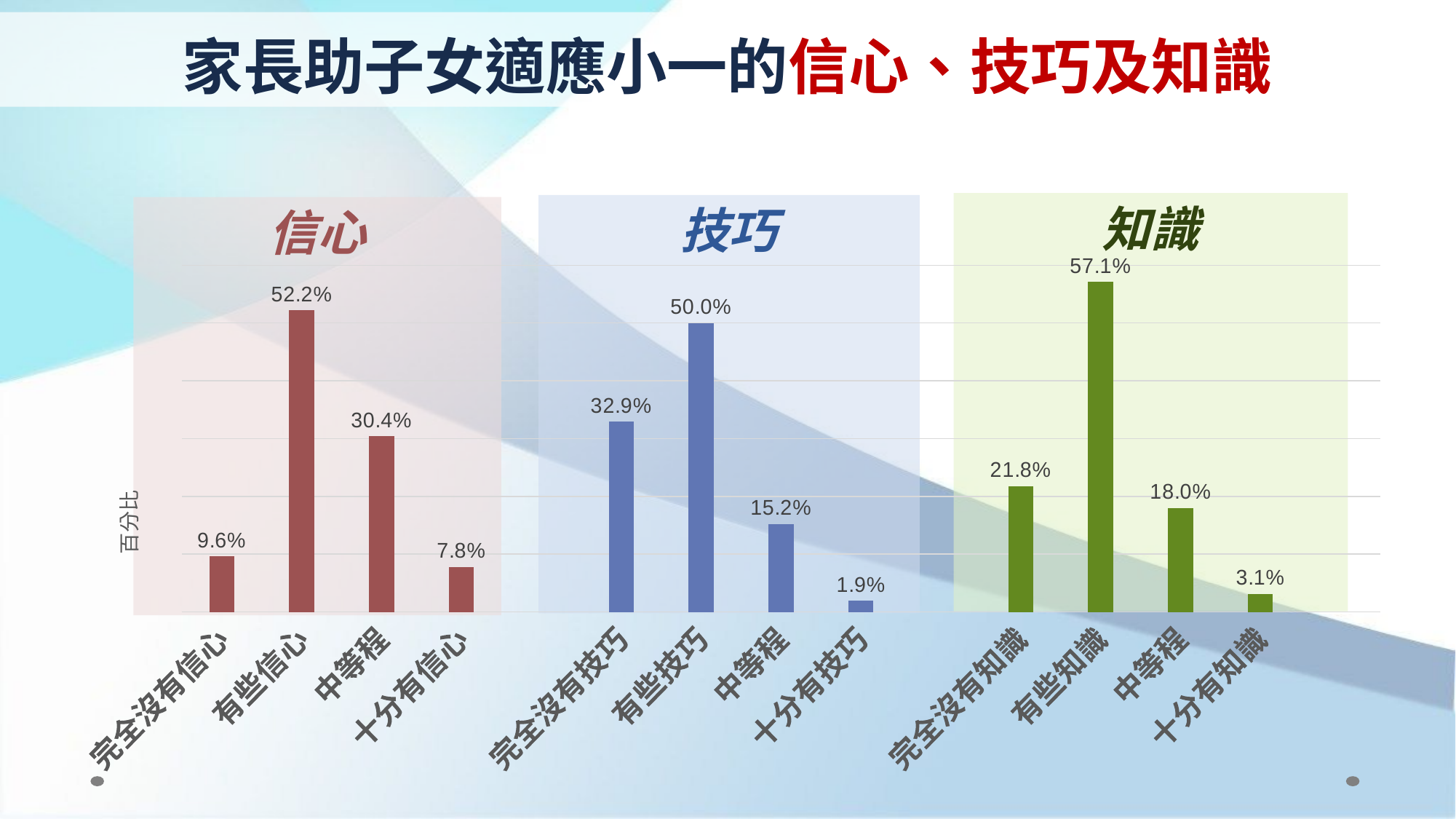
Which category has the lowest value on the chart? 十分有技巧 How many categories are plotted on the chart? 12 What is the value for 中等程 in the 技巧 group? 15.2% What is the value for 十分有技巧? 1.9% What is the difference between 有些知識 and 有些技巧? 7.1% What is the difference between 中等程 in the 信心 group and 中等程 in the 知識 group? 12.4% Which category has the highest value on the chart? 有些知識 What is the value for 完全沒有知識? 21.8% What is the label of the vertical axis? 百分比 What kind of chart is shown on the slide? bar chart Which is larger, 完全沒有技巧 or 完全沒有信心? 完全沒有技巧 What is the value for 有些信心? 52.2%